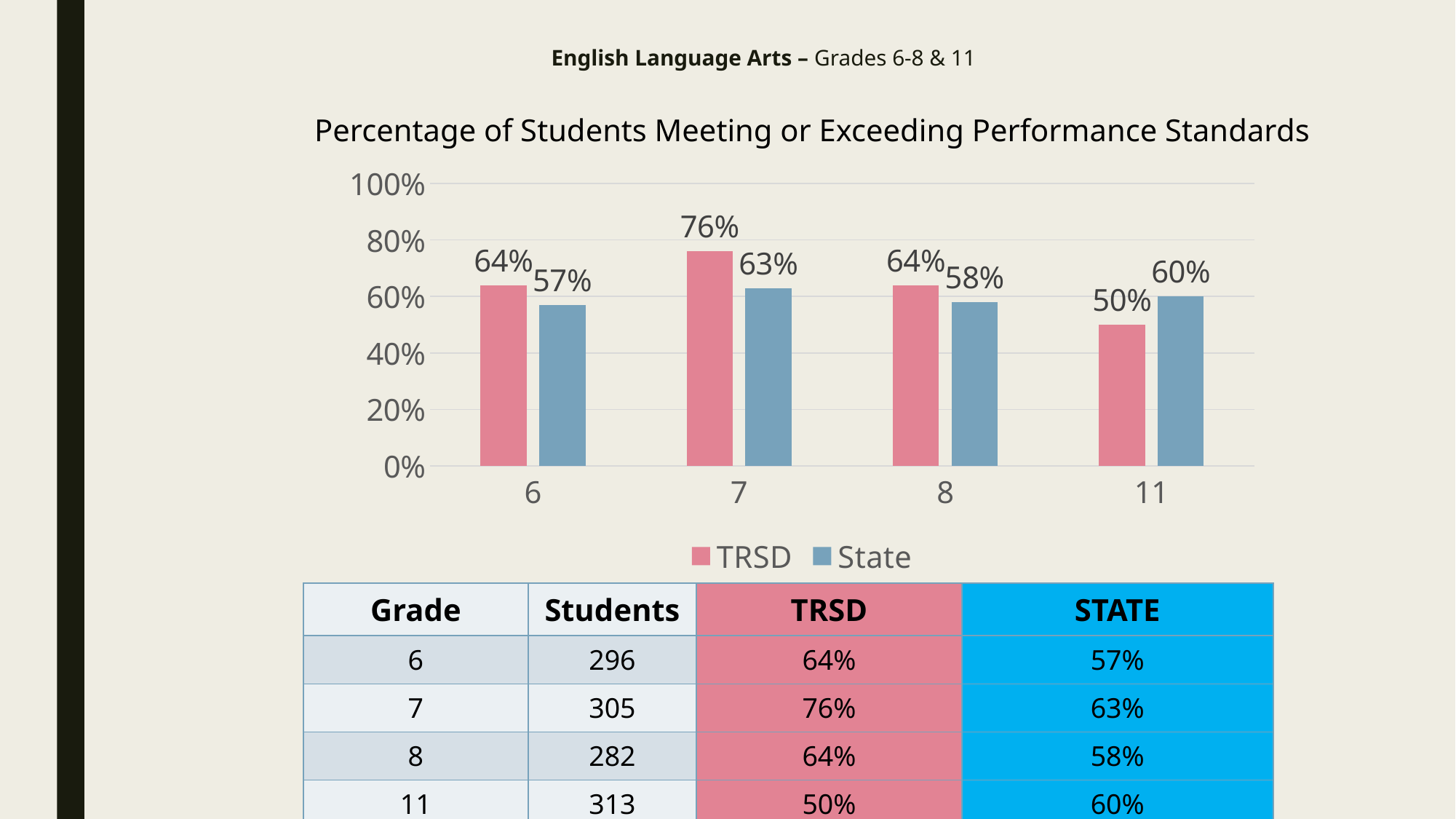
What is the State value for grade 11? 60% What kind of chart is shown? Bar chart Which grade has the lowest TRSD value? 11 For grade 11, which is larger, the TRSD value or the State value? State What is the State value for grade 6? 57% What is the difference between the TRSD and State values for grade 7? 13% What is the title of the chart? Percentage of Students Meeting or Exceeding Performance Standards What is the TRSD value for grade 7? 76% Which grade has the lowest State value? 6 How many grades are shown on the x axis? 4 How many series does the legend list? 2 Which grade has the highest TRSD value? 7